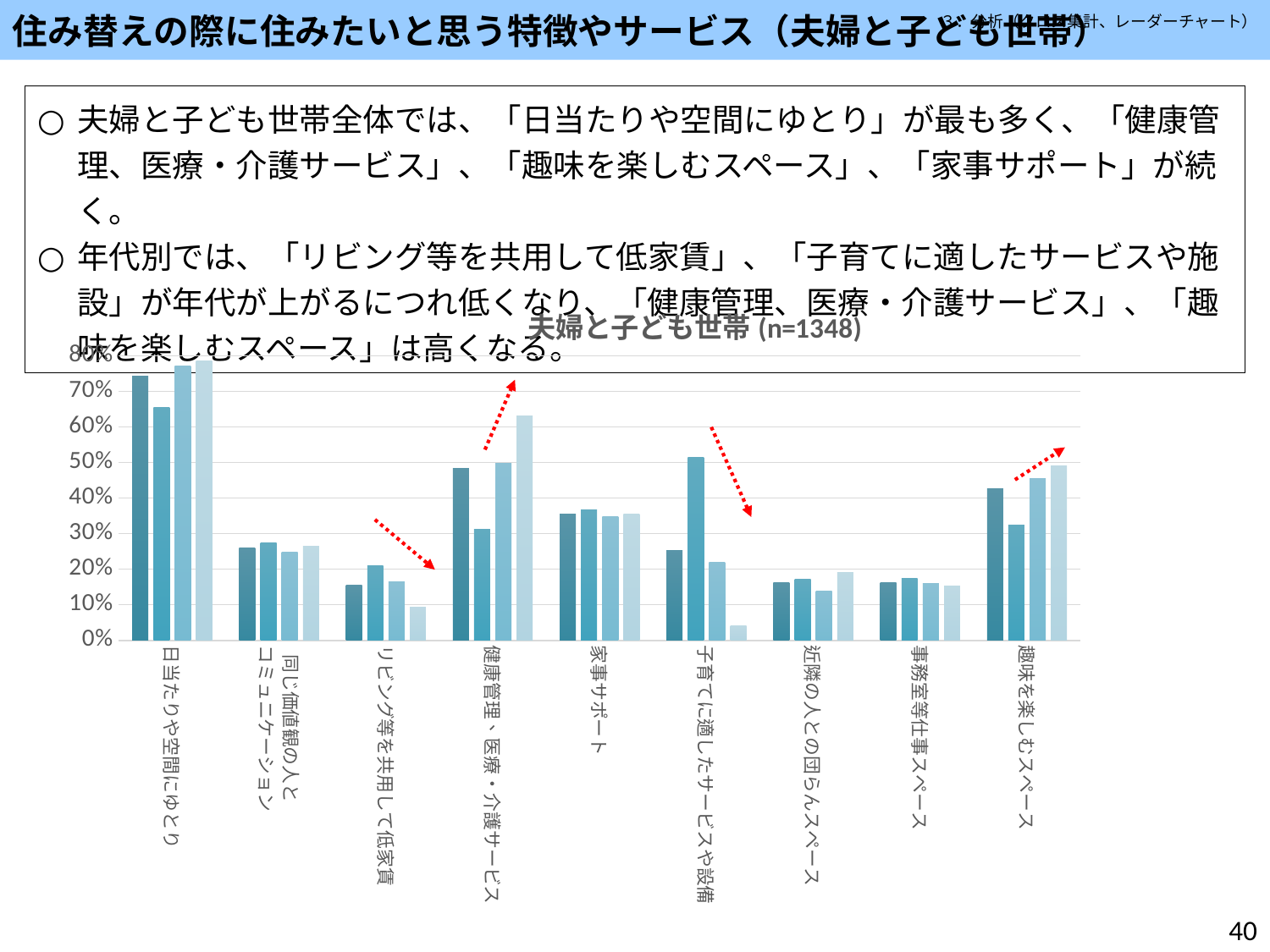
What is the sample size (n) shown in the chart title? 1348 Is the tallest bar for 健康管理、医療・介護サービス taller or shorter than the tallest bar for 家事サポート? taller How many categories are shown on the x axis of the chart? 9 Which category contains the tallest bar in the chart? 日当たりや空間にゆとり Are all the bars for 日当たりや空間にゆとり greater or less than 60%? greater Are all the bars for リビング等を共用して低家賃 greater or less than 30%? less Are all the bars for 事務室等仕事スペース greater or less than 20%? less What kind of chart is shown on the slide? bar chart How many bars are plotted for each category in the chart? 4 Which category contains the shortest bar in the chart? 子育てに適したサービスや設備 What is the title of the chart? 夫婦と子ども世帯 (n=1348)